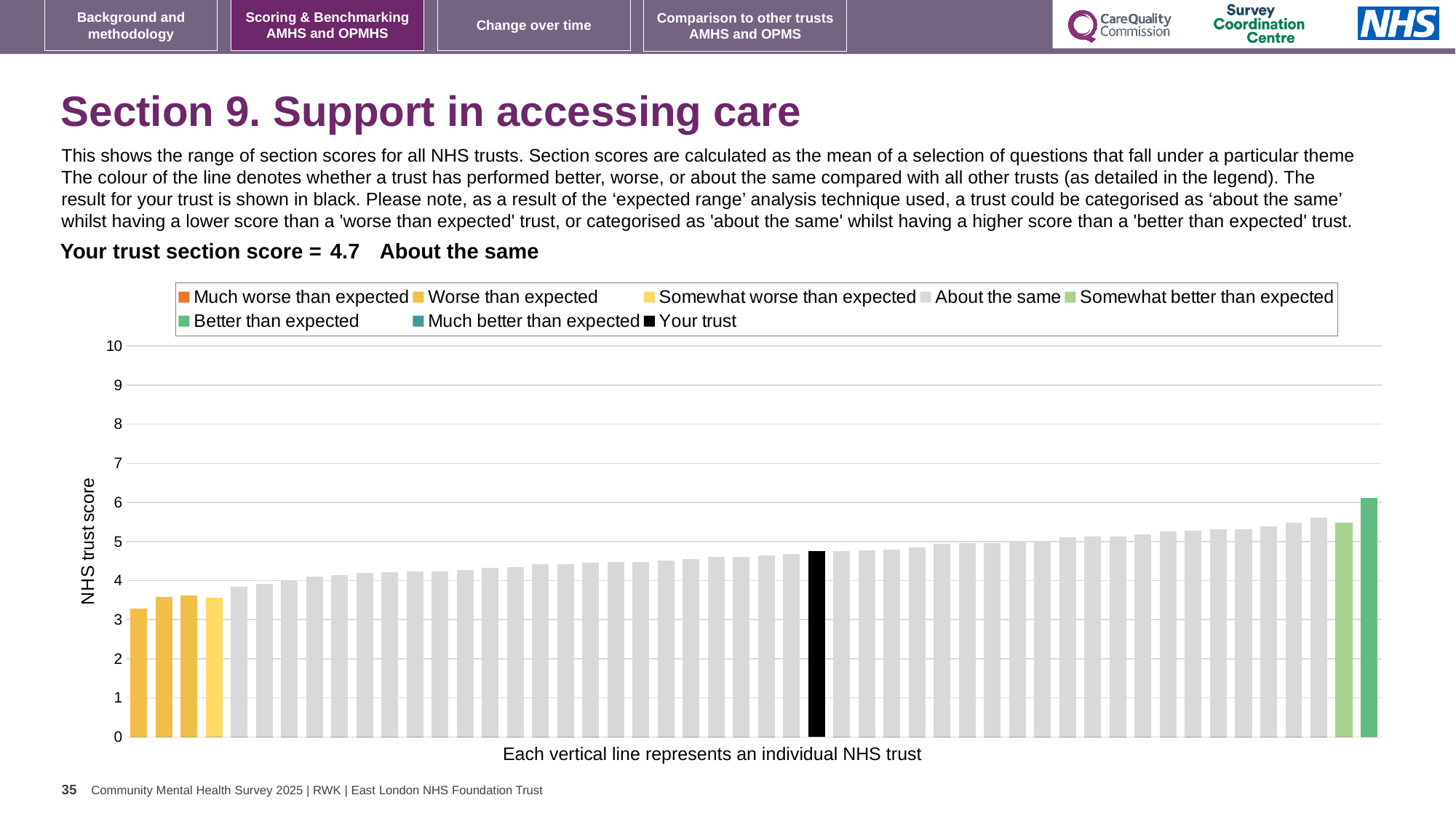
How many bars are coloured as 'Worse than expected' (the yellow bars at the left)? 3 Which category is your trust placed in for this section? About the same Is the value of the black 'Your trust' bar greater or less than 5? less Is the value of the shortest bar greater or less than 4? less Is the value of the black 'Your trust' bar greater or less than 4? greater How many entries does the chart legend list? 8 What is the section score for your trust shown on the slide? 4.7 Which is larger: the value of the black 'Your trust' bar or the value of the rightmost green bar? The rightmost green bar What kind of chart is shown on the slide? Bar chart Do the bar values rise or fall from left to right along the x axis? rise What is the label on the vertical axis of the chart? NHS trust score